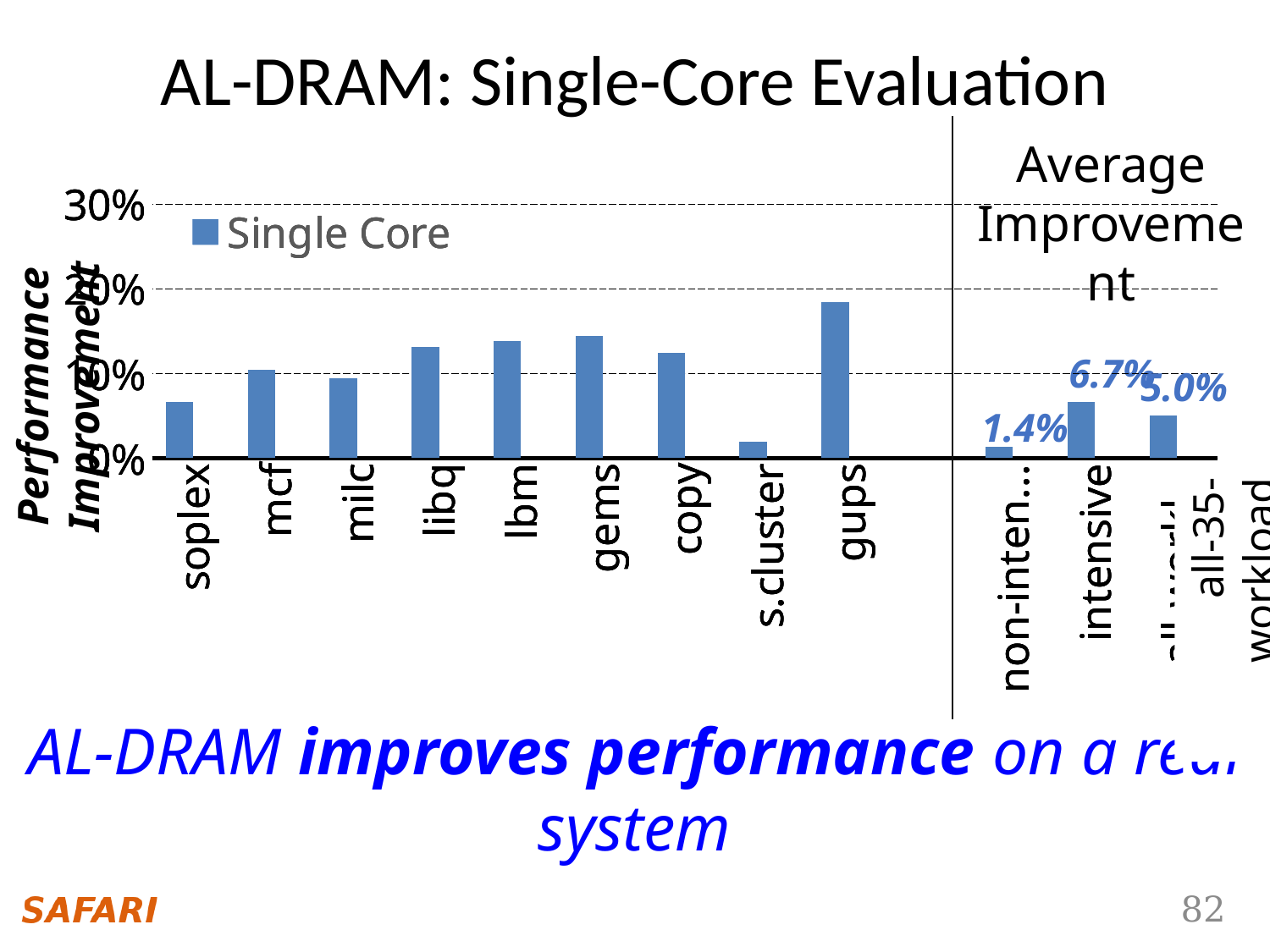
What kind of chart is shown on the slide? Bar chart What is the performance improvement value shown for the all-35-workload category? 5.0% Is the performance improvement for lbm greater or less than 10%? greater Is the performance improvement for gups greater or less than 10%? greater How many series does the legend list? 1 Is the performance improvement for s.cluster greater or less than 10%? less Which has a larger performance improvement, intensive or all-35-workload? intensive Which benchmark has the highest performance improvement bar? gups What is the difference between the intensive (6.7%) and non-intensive (1.4%) average improvement values? 5.3% Which has a larger performance improvement, gups or mcf? gups What value is labelled on the bar for the category labelled 'non-inten…'? 1.4% What is the performance improvement value shown for the intensive workload? 6.7%